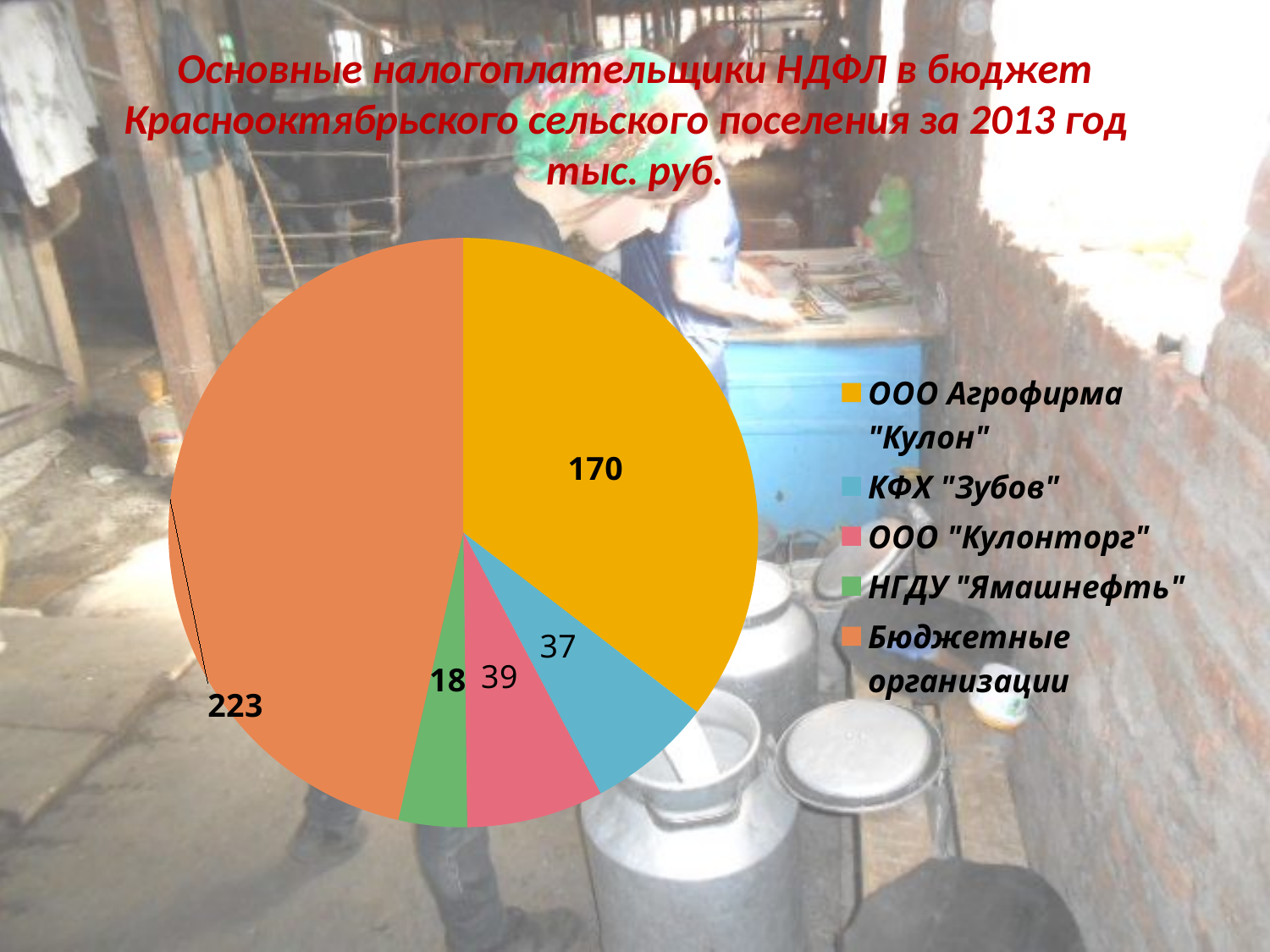
What is the value for НГДУ "Ямашнефть"? 18 What is the value for Бюджетные организации? 223 What is the difference between the values for Бюджетные организации and ООО Агрофирма "Кулон"? 53 What is the total of all the values shown in the pie chart? 487 Which category has the smallest slice of the pie? НГДУ "Ямашнефть" What is the value for КФХ "Зубов"? 37 Which is larger, the value for ООО "Кулонторг" or the value for НГДУ "Ямашнефть"? ООО "Кулонторг" How many categories does the pie chart show? 5 What type of chart is shown on the slide? pie chart Which category has the largest slice of the pie? Бюджетные организации What colour is the slice for ООО Агрофирма "Кулон"? yellow What is the value for ООО Агрофирма "Кулон"? 170